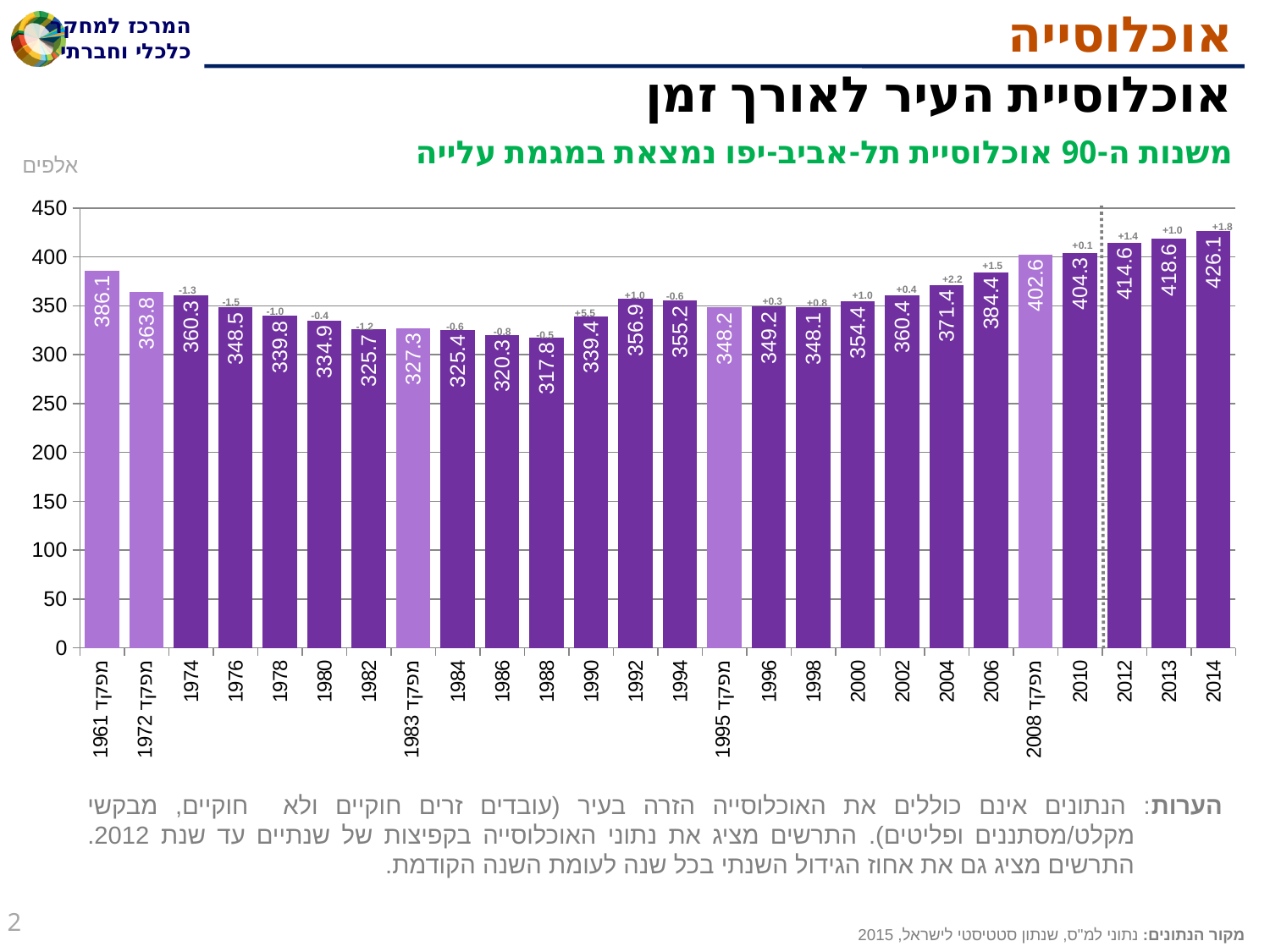
What is the value for 2014? 426.1 What kind of chart is shown on the slide? Bar chart What is the value for the 2008 census (מפקד 2008)? 402.6 What is the difference between the values for 2014 and 2013? 7.5 How many bars are shown in the chart? 26 Which year has the highest value? 2014 Which is larger, the value for 1992 or the value for 1994? 1992 Which year has the lowest value? 1988 Is the value for 2010 greater or less than 400? greater What is the difference between the values for the 1961 census and the 1972 census? 22.3 What is the value for 1988? 317.8 What is the value for the 1961 census (מפקד 1961)? 386.1